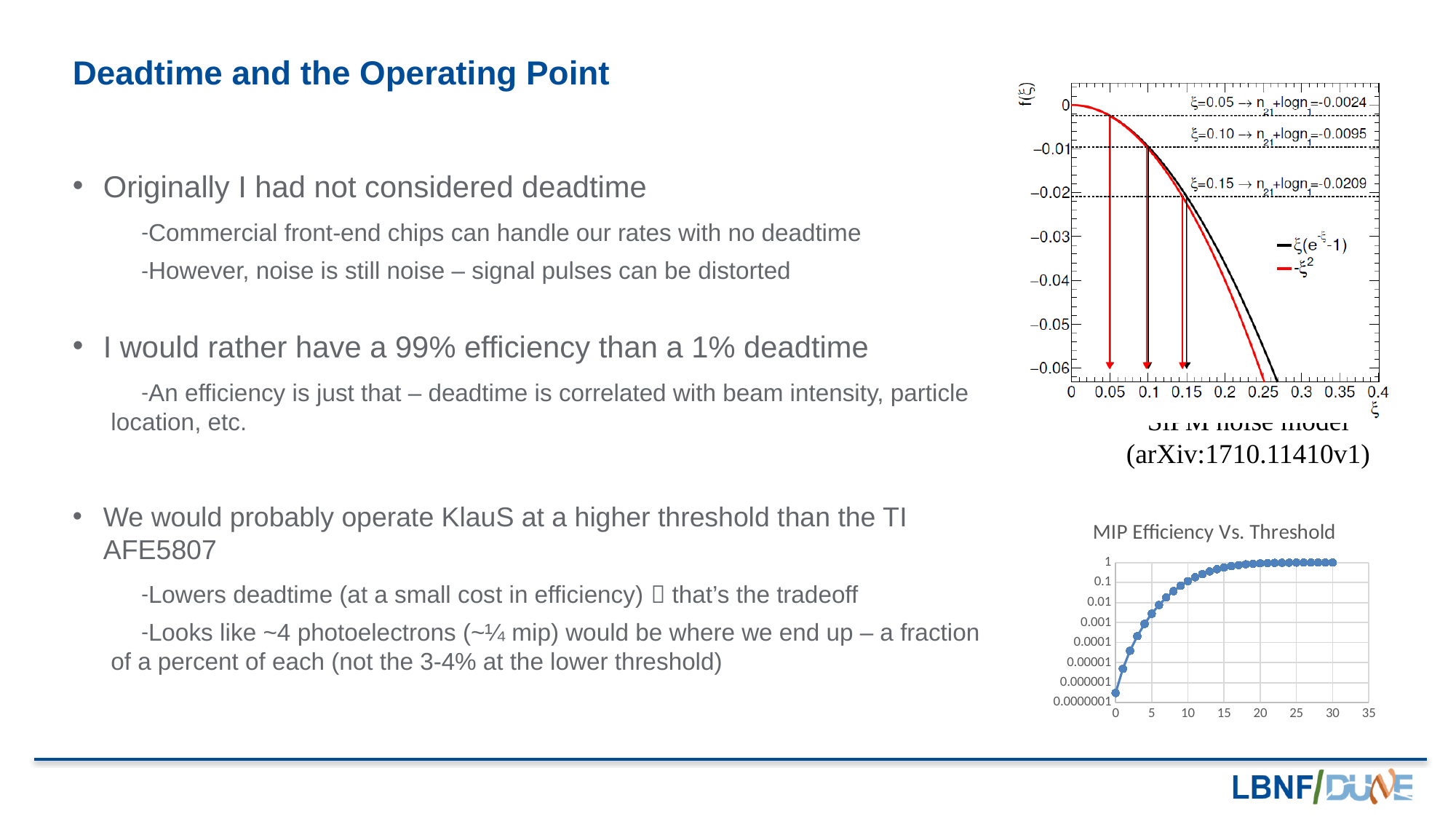
What is the title of the chart at the bottom right of the slide? MIP Efficiency Vs. Threshold How many series does the legend of the SiPM noise model chart (top right) list? 2 In the SiPM noise model chart (top right), what value of n21+logn1 is annotated for ξ=0.15? -0.0209 In the SiPM noise model chart (top right), what value of n21+logn1 is annotated for ξ=0.10? -0.0095 What kind of chart is the SiPM noise model chart at the top right of the slide? line chart In the 'MIP Efficiency Vs. Threshold' chart, is the value at threshold 30 greater or less than 0.1? greater In the SiPM noise model chart (top right), do the curves rise or fall as ξ increases along the x axis? fall In the 'MIP Efficiency Vs. Threshold' chart, is the value at threshold 0 greater or less than 0.00001? less In the 'MIP Efficiency Vs. Threshold' chart, do the plotted values rise or fall as the threshold increases along the x axis? rise In the 'MIP Efficiency Vs. Threshold' chart, is the value at threshold 20 greater or less than 0.1? greater In the SiPM noise model chart (top right), what value of n21+logn1 is annotated for ξ=0.05? -0.0024 In the 'MIP Efficiency Vs. Threshold' chart, what is the highest value shown on the y axis? 1